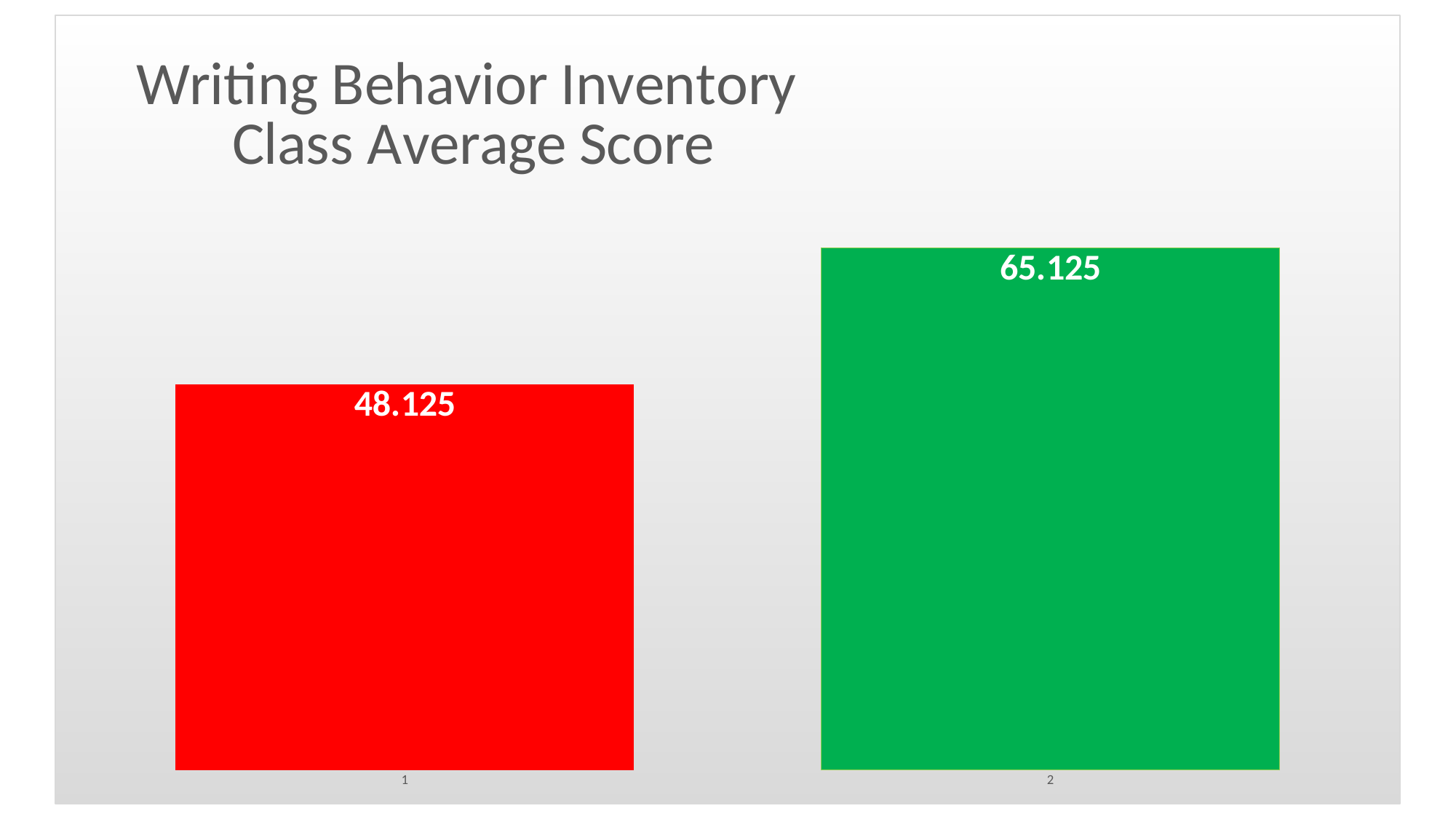
Which is larger, the value for category 1 or the value for category 2? category 2 How many bars are shown in the chart? 2 What is the value for category 1? 48.125 Do the values rise or fall from category 1 to category 2? rise What is the difference between the values for category 2 and category 1? 17 What colour is the bar for category 2? green What is the value for category 2? 65.125 What kind of chart is shown on the slide? bar chart What is the title of the slide? Writing Behavior Inventory Class Average Score Which category has the highest value? 2 Which category has the lowest value? 1